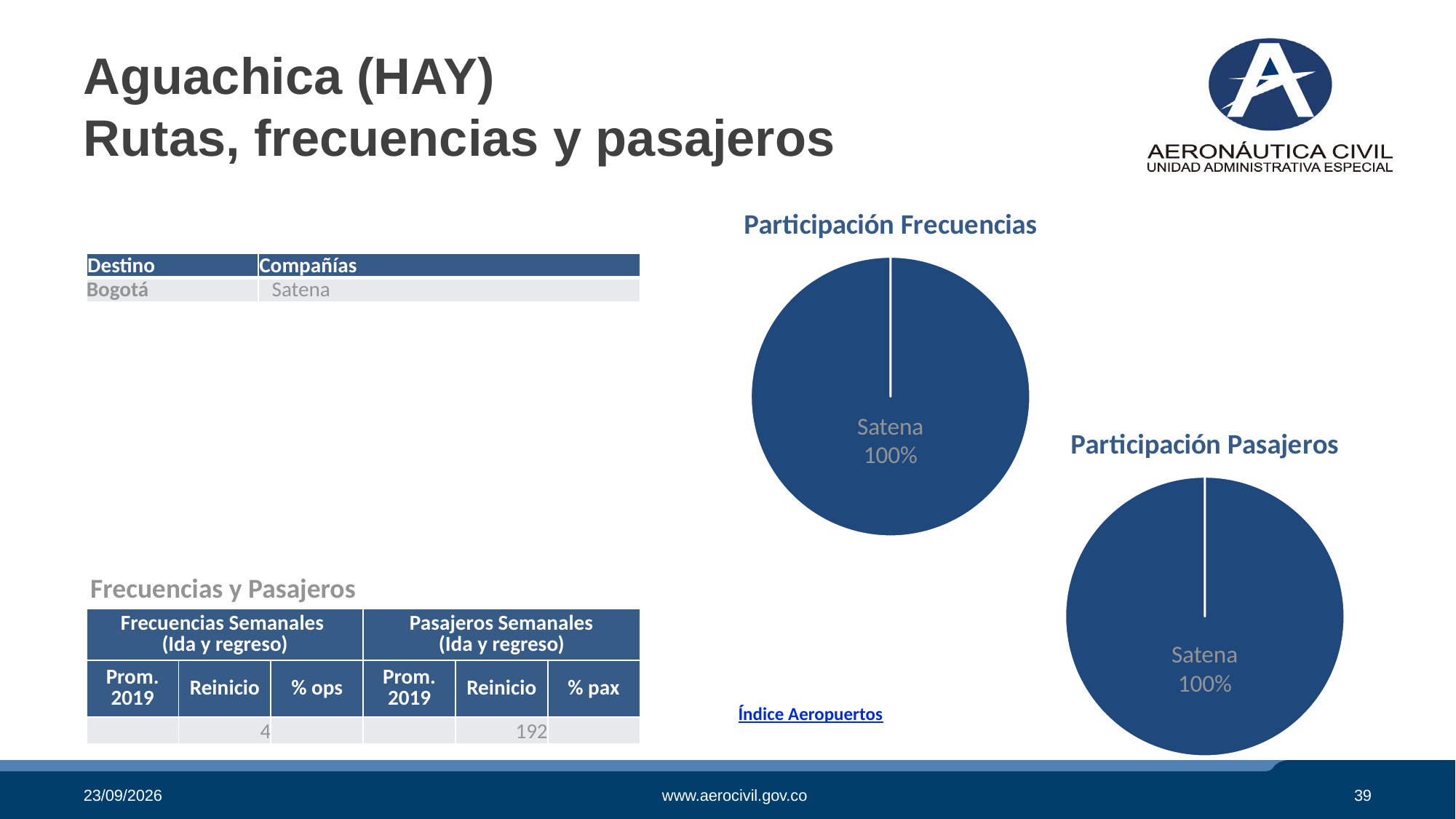
How many slices does the 'Participación Frecuencias' pie chart have? 1 What is the title of the pie chart on the lower right of the slide? Participación Pasajeros In the 'Participación Pasajeros' chart, which company is shown? Satena How many slices does the 'Participación Pasajeros' pie chart have? 1 In the 'Participación Frecuencias' chart, what share does Satena have? 100% In the 'Participación Frecuencias' chart, which company is shown? Satena What is the title of the pie chart on the upper right of the slide? Participación Frecuencias How many pie charts are on the slide? 2 What kind of chart is 'Participación Pasajeros'? Pie chart In the 'Participación Pasajeros' chart, what share does Satena have? 100% What kind of chart is 'Participación Frecuencias'? Pie chart